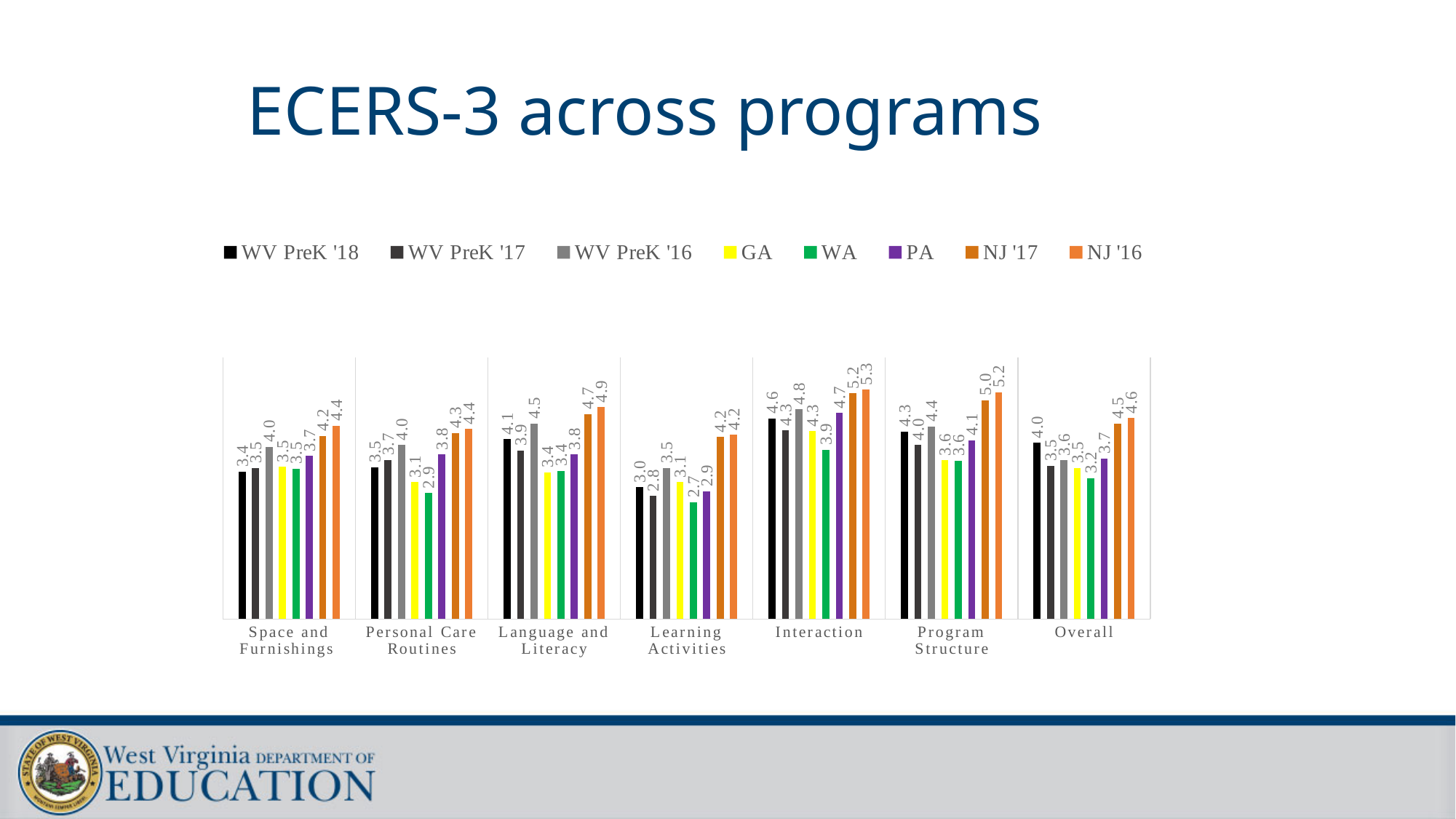
What is the title of the slide? ECERS-3 across programs Which series has the highest value in Program Structure? NJ '16 Which series has the lowest value in Personal Care Routines? WA How many categories are shown on the x axis? 7 What is the value for NJ '16 in Interaction? 5.3 How many series does the legend list? 8 What is the value for WA in Learning Activities? 2.7 What kind of chart is shown on the slide? Bar chart What is the value for GA in Personal Care Routines? 3.1 What is the difference between the NJ '16 and WV PreK '18 values in Language and Literacy? 0.8 Which is larger in Overall: the value for PA or the value for WV PreK '17? PA What is the Overall value for WV PreK '18? 4.0